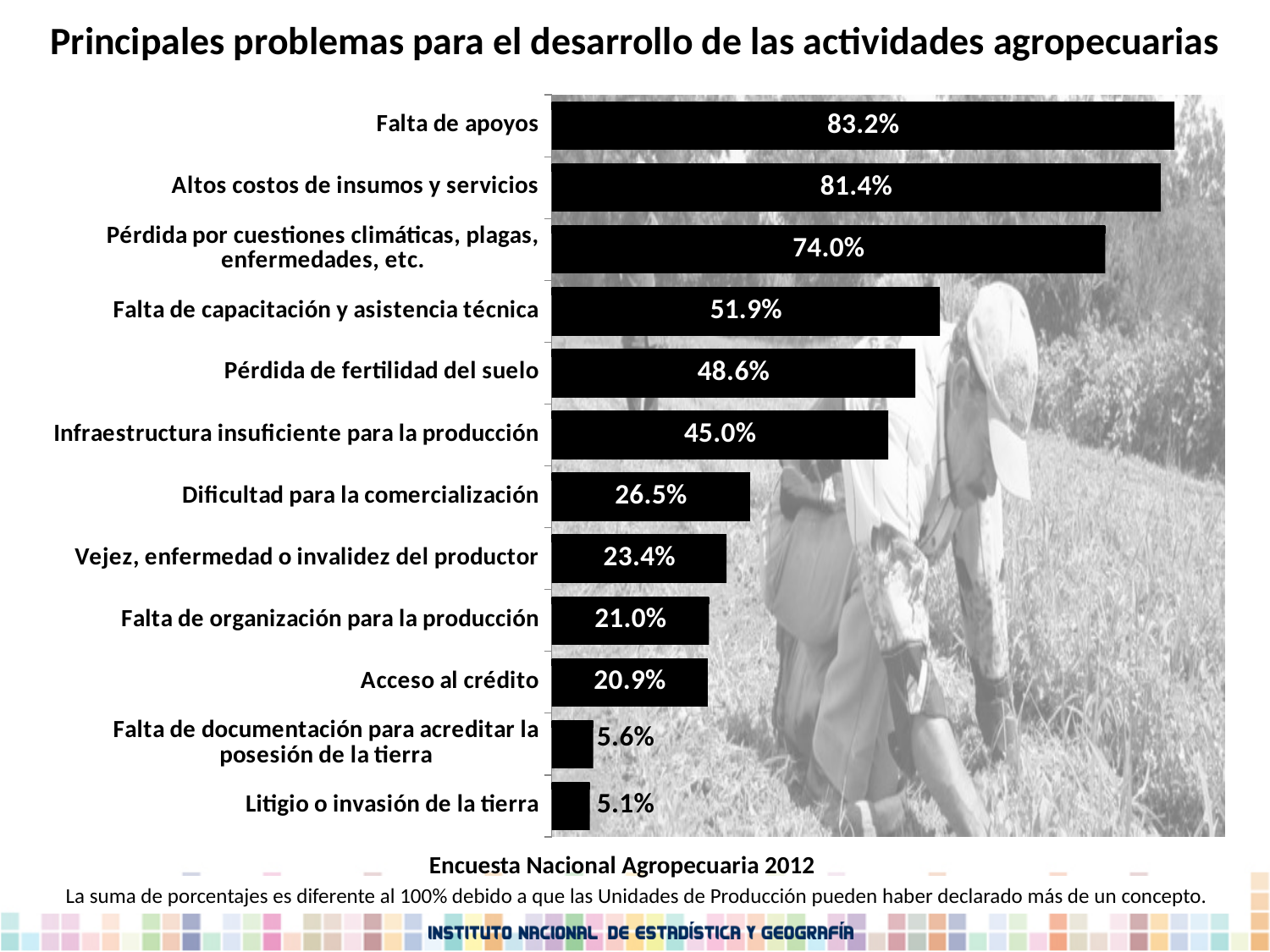
How many categories are shown in the chart? 12 What is the value for Falta de apoyos? 83.2% What is the value for Acceso al crédito? 20.9% What kind of chart is shown on the slide? Bar chart Which category has the highest value? Falta de apoyos Which category has the lowest value? Litigio o invasión de la tierra What is the difference between Falta de capacitación y asistencia técnica and Infraestructura insuficiente para la producción? 6.9% What is the title of the chart? Principales problemas para el desarrollo de las actividades agropecuarias Which is larger: Dificultad para la comercialización or Vejez, enfermedad o invalidez del productor? Dificultad para la comercialización Which is larger: Pérdida por cuestiones climáticas, plagas, enfermedades, etc. or Falta de capacitación y asistencia técnica? Pérdida por cuestiones climáticas, plagas, enfermedades, etc. What is the value for Pérdida de fertilidad del suelo? 48.6% What is the difference between Falta de apoyos and Altos costos de insumos y servicios? 1.8%